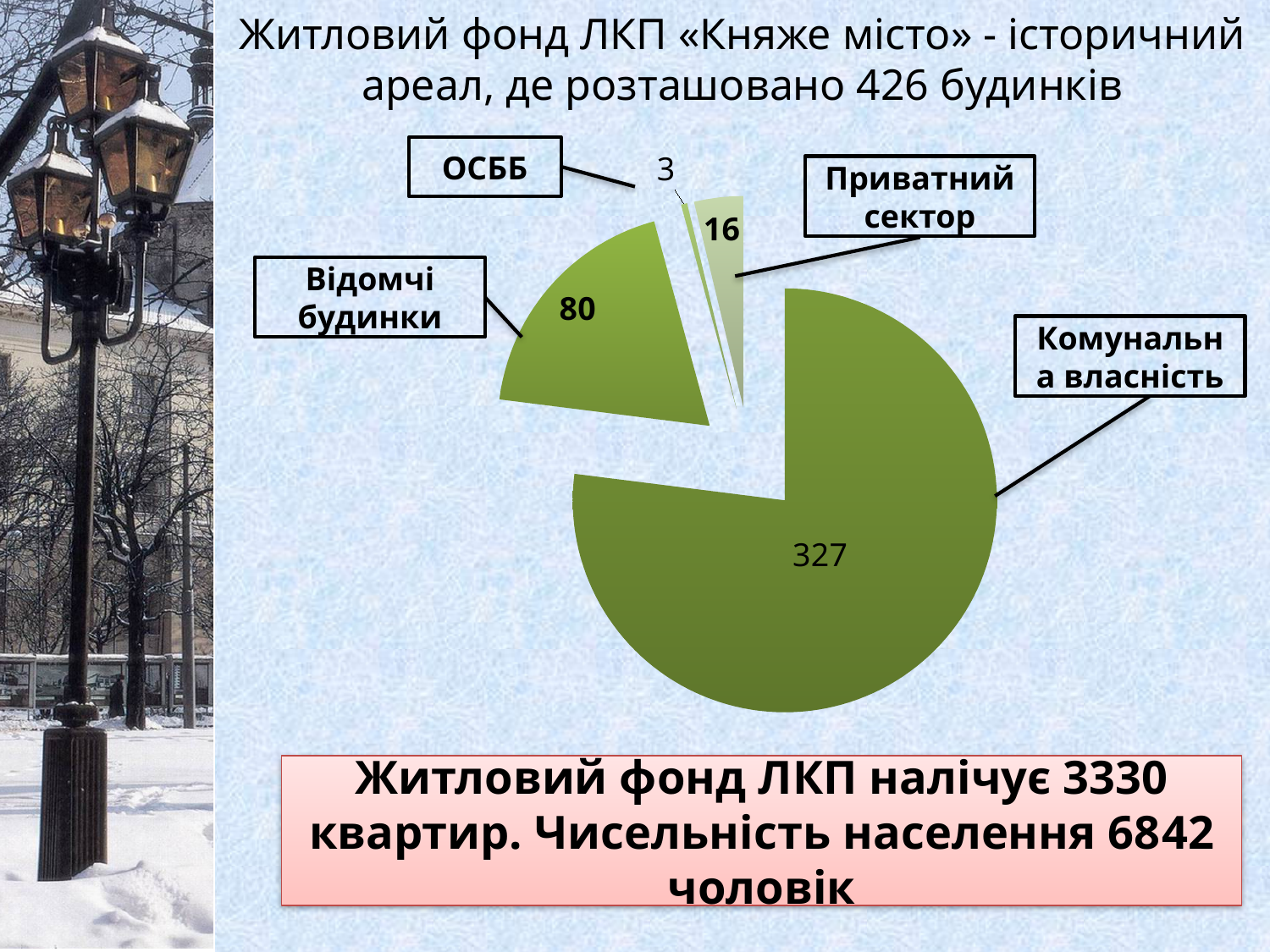
Which category has the smallest slice of the pie? ОСББ According to the slide title, how many buildings are located in the historical area? 426 What is the total of all the slices in the pie chart? 426 What is the value for Відомчі будинки? 80 What is the difference between the values for Комунальна власність and Відомчі будинки? 247 How many slices does the pie chart have? 4 Which is larger, the value for Відомчі будинки or the value for Приватний сектор? Відомчі будинки What is the value for ОСББ? 3 What is the value for Комунальна власність? 327 What kind of chart is shown on the slide? pie chart Which category has the largest slice of the pie? Комунальна власність What is the value for Приватний сектор? 16